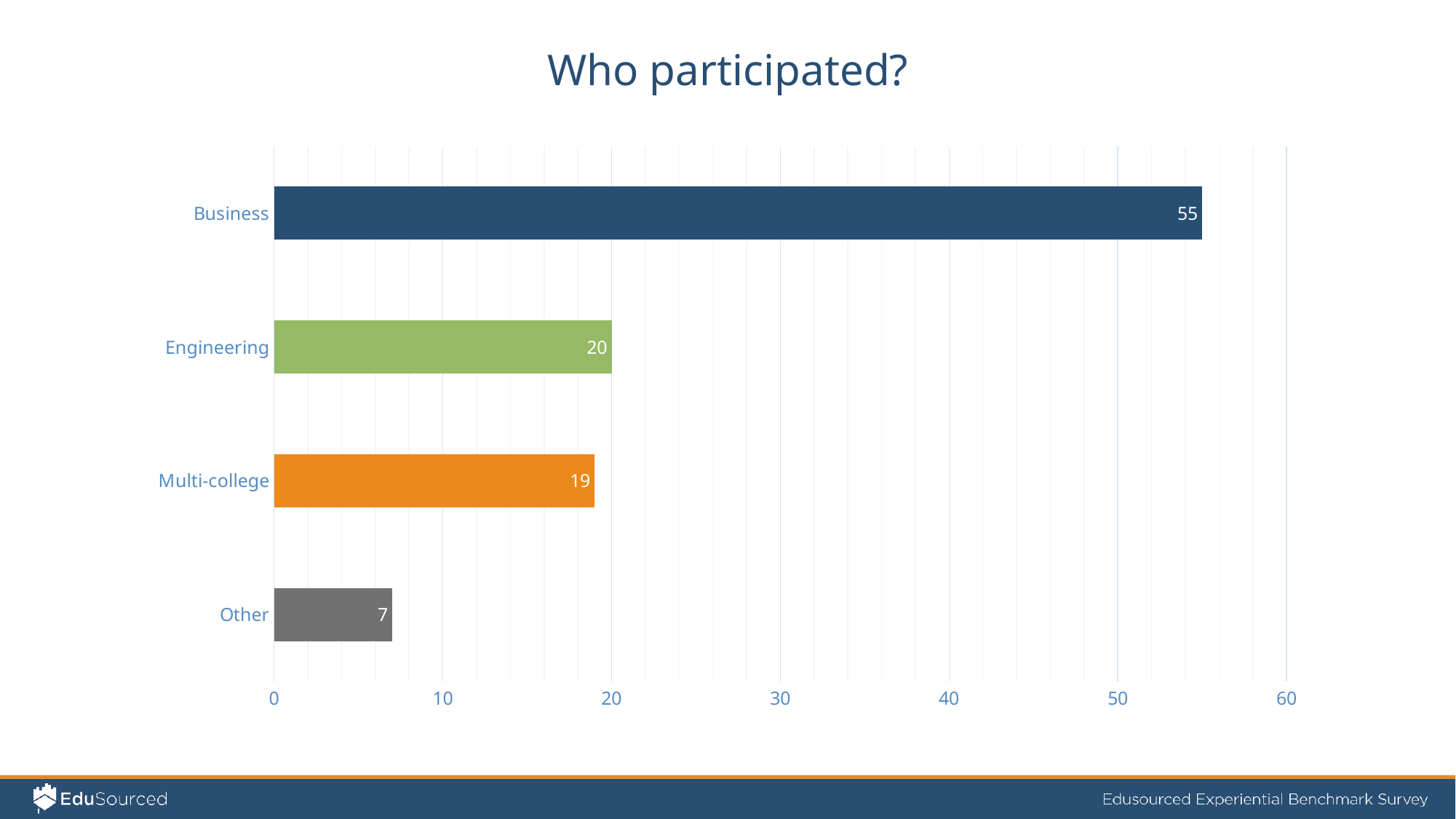
Which category has the highest value? Business What is the value for Engineering? 20 Is the value for Business greater or less than 50? greater What is the difference between the values for Business and Engineering? 35 What is the value for Business? 55 What is the difference between the values for Multi-college and Other? 12 What is the value for Multi-college? 19 Which category has the lowest value? Other What is the value for Other? 7 Which is larger, the value for Engineering or the value for Other? Engineering How many categories are shown in the chart? 4 What kind of chart is shown on the slide? bar chart